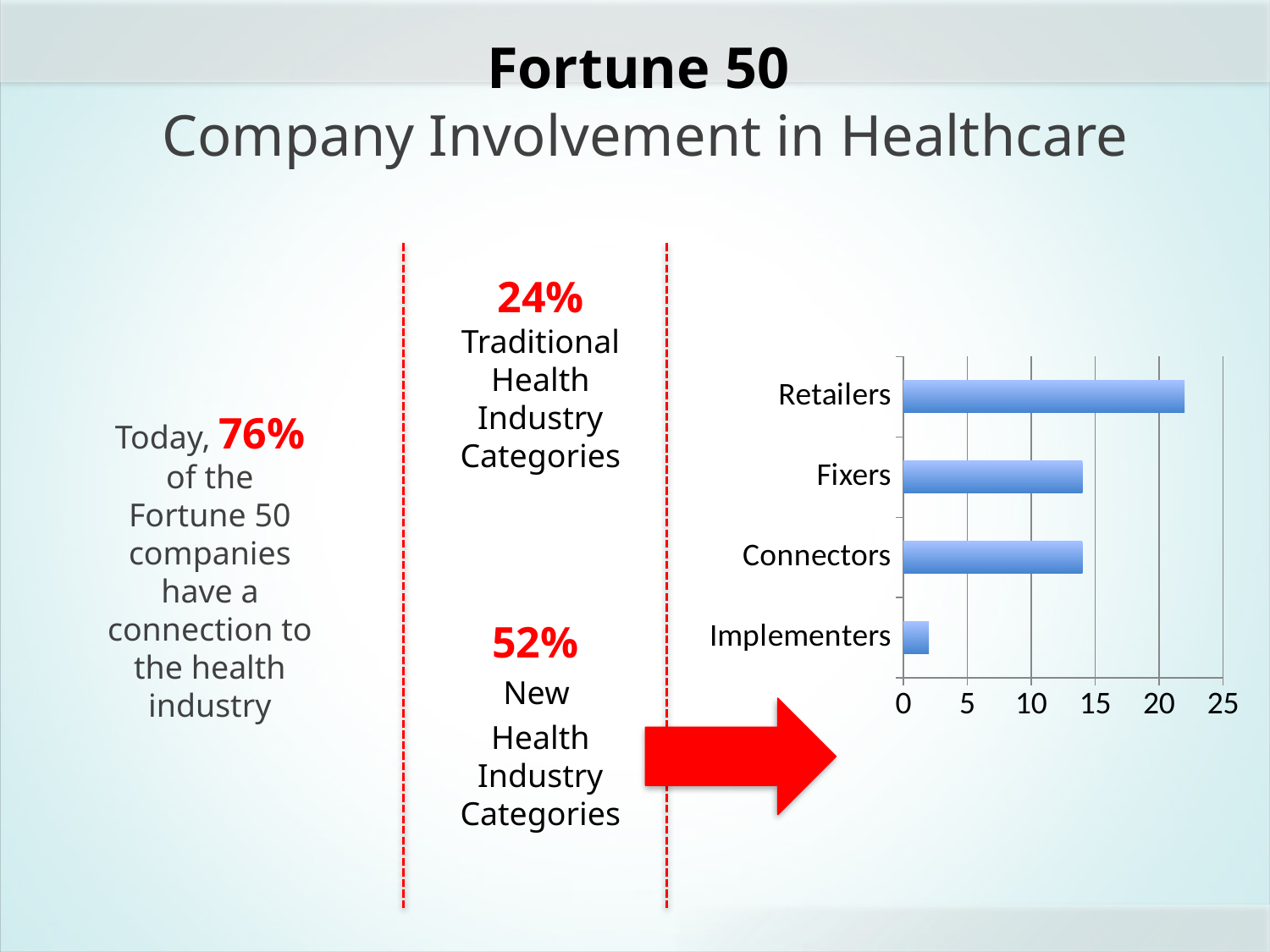
What kind of chart is shown on the slide? bar chart Is the value for Fixers greater or less than 15? less Is the value for Retailers greater or less than 20? greater Which category is listed at the top of the bar chart? Retailers Which is larger, the value for Retailers or the value for Fixers? Retailers Which is larger, the value for Connectors or the value for Implementers? Connectors How many categories does the bar chart show? 4 Is the value for Connectors greater or less than 10? greater Which category has the lowest value in the bar chart? Implementers Which category has the highest value in the bar chart? Retailers What is the maximum value shown on the horizontal axis of the bar chart? 25